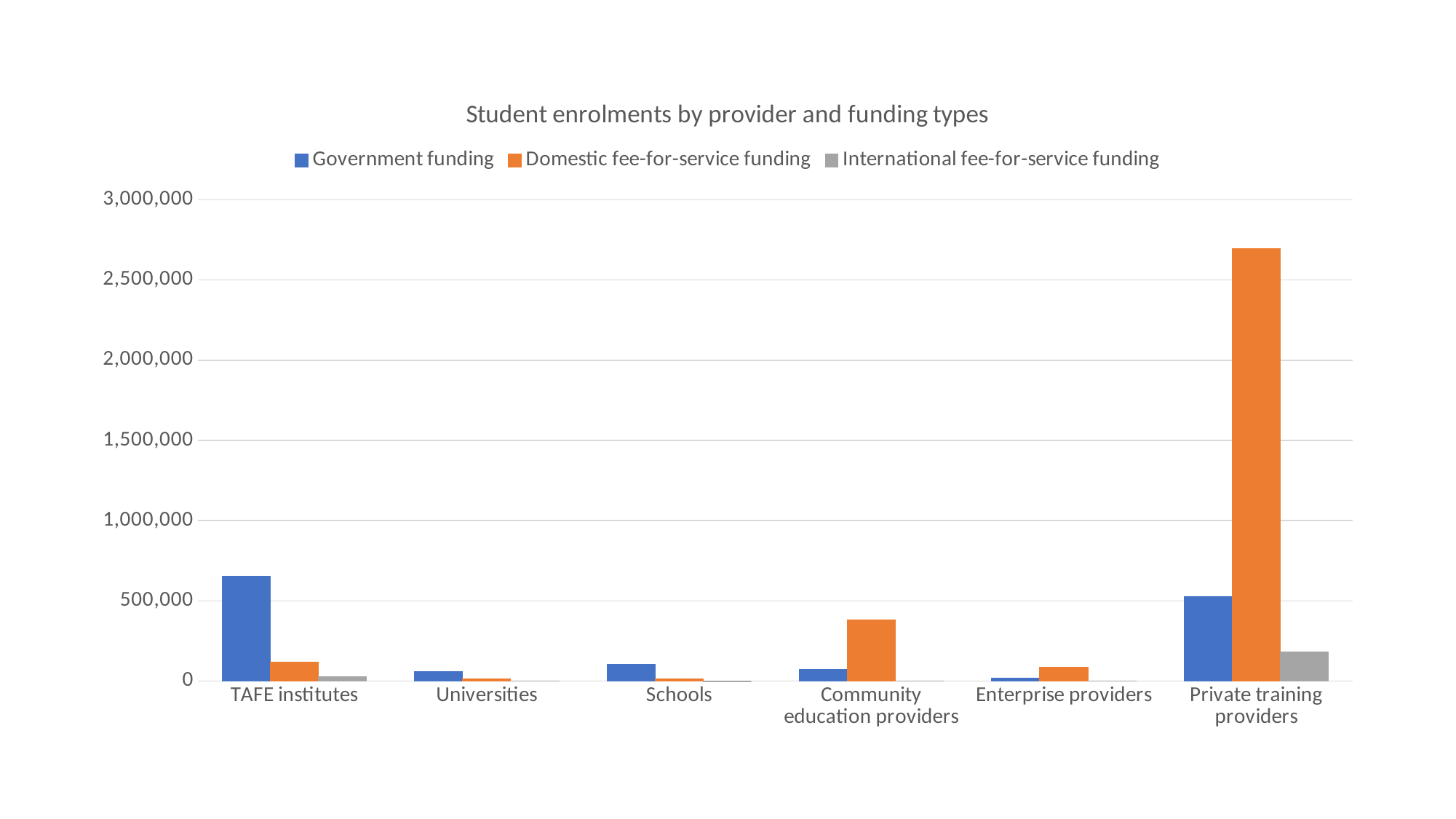
Is the Domestic fee-for-service funding value for Private training providers greater or less than 2,500,000? greater Is the Domestic fee-for-service funding value for Community education providers greater or less than 500,000? less Which colour represents International fee-for-service funding in the chart? grey For TAFE institutes, which is larger: Government funding or Domestic fee-for-service funding? Government funding What is the title of the chart? Student enrolments by provider and funding types Is the Government funding value for TAFE institutes greater or less than 500,000? greater Which provider has the highest Government funding enrolments? TAFE institutes Which provider has the highest Domestic fee-for-service funding enrolments? Private training providers For Community education providers, which is larger: Government funding or Domestic fee-for-service funding? Domestic fee-for-service funding What kind of chart is shown on the slide? bar chart How many provider categories are shown on the x axis? 6 How many series does the legend list? 3